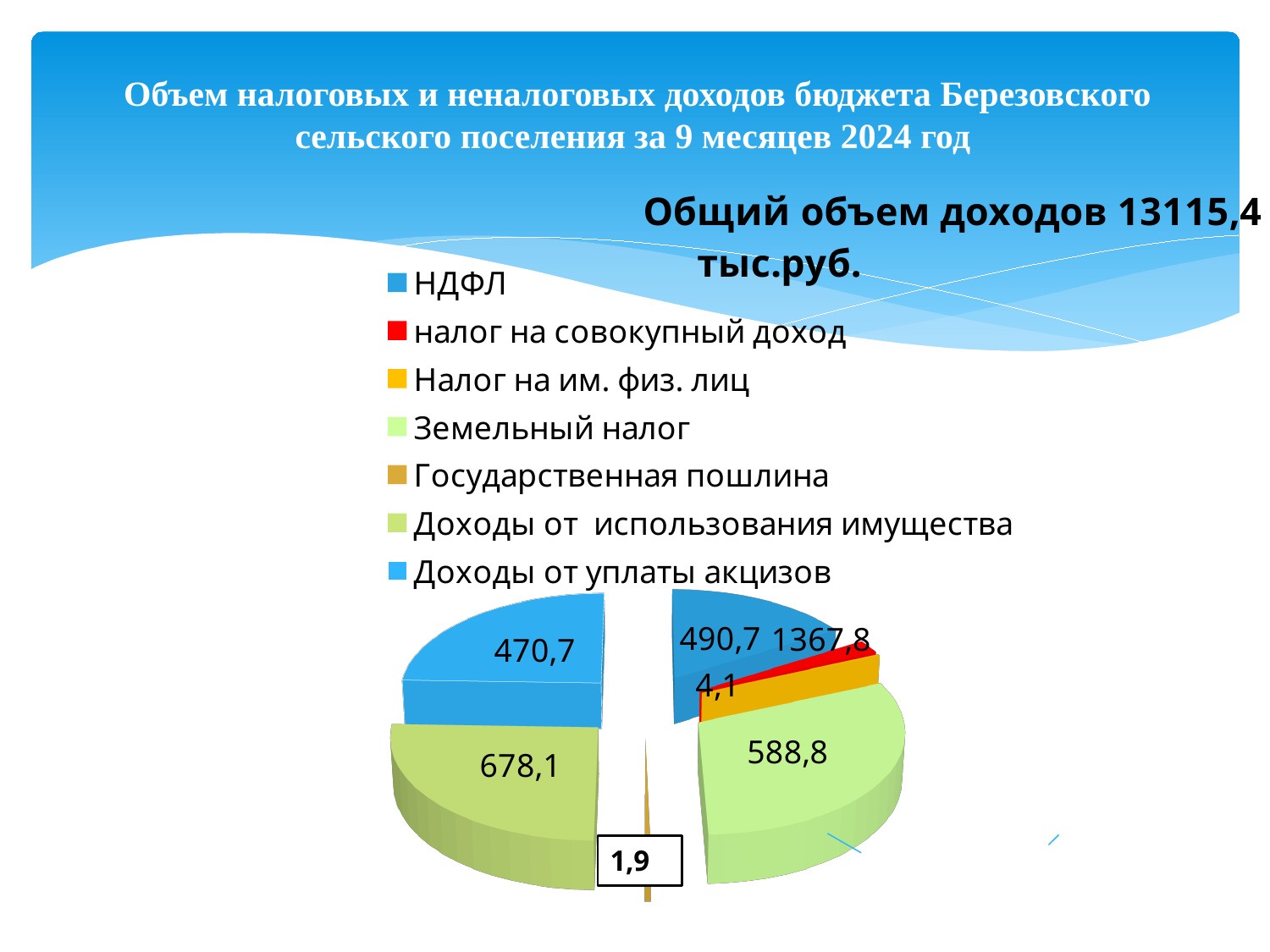
What is the value shown for Земельный налог? 588,8 What is the value shown for Государственная пошлина? 1,9 What is the difference between Доходы от использования имущества (678,1) and Земельный налог (588,8)? 89,3 Which legend entry is shown in red? налог на совокупный доход What kind of chart is shown on the slide? pie chart What is the value shown for Доходы от использования имущества? 678,1 How many categories does the legend of the pie chart list? 7 Which category has the smallest slice in the pie chart? Государственная пошлина What total revenue amount is stated in the text above the chart? 13115,4 тыс.руб. Which is larger: Земельный налог or Доходы от использования имущества? Доходы от использования имущества What is the value shown for Доходы от уплаты акцизов? 470,7 What is the difference between Доходы от использования имущества (678,1) and Доходы от уплаты акцизов (470,7)? 207,4